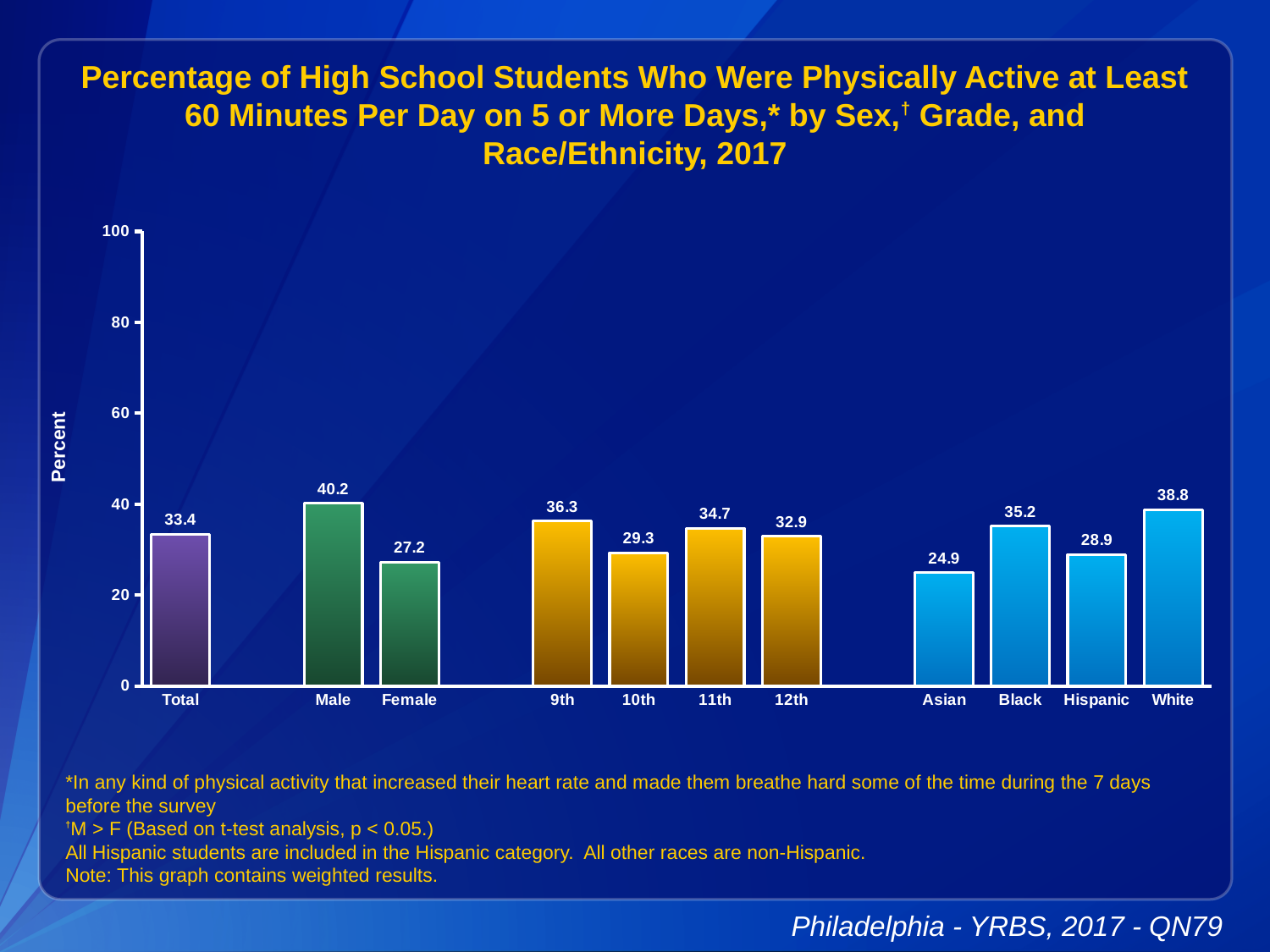
What is the value for Male? 40.2 What is the label on the y axis? Percent What is the difference between the Male and Female values? 13.0 Which category has the lowest value? Asian What is the value for 11th grade? 34.7 What kind of chart is this? bar chart Is the value for White greater or less than 40? less What is the value for Asian? 24.9 Which category has the highest value? Male What is the difference between the 9th grade and 10th grade values? 7.0 Which is larger, the value for Black or the value for Hispanic? Black How many categories are shown on the x axis? 11